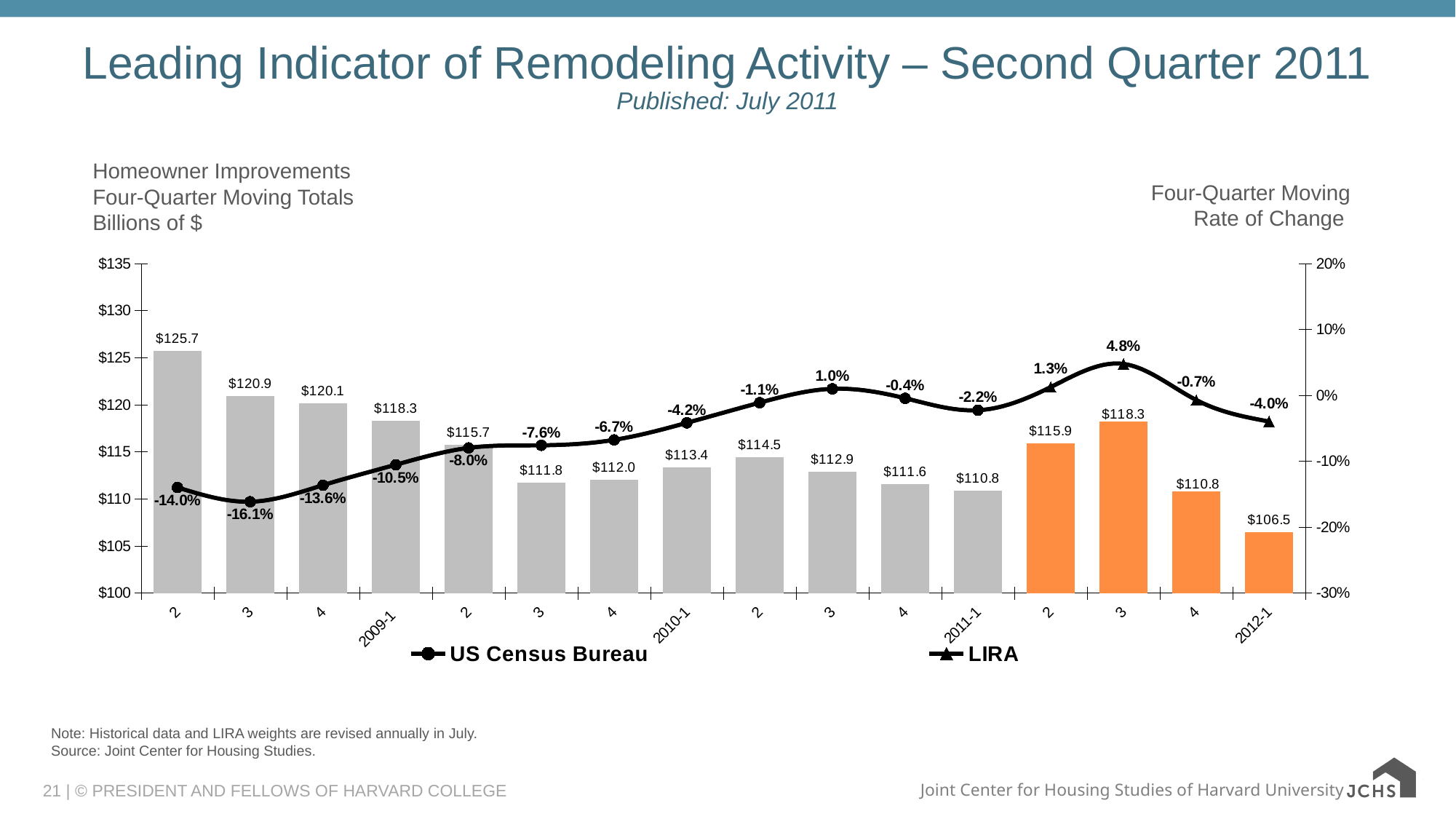
What is the lowest rate-of-change value labeled on the line? -16.1% What is the value of the bar for 2009-1? $118.3 How many bars are plotted on the chart? 16 What is the US Census Bureau rate of change shown for 2010-1? -4.2% How many series does the legend list? 2 Which quarter has the lowest bar value on the chart? 2012-1 What is the LIRA rate of change shown for 2012-1? -4.0% What is the highest bar value shown on the chart? $125.7 Which bar is larger, 2010-1 or 2011-1? 2010-1 What is the value of the bar for 2012-1? $106.5 What is the highest rate-of-change value labeled on the line? 4.8% What is the difference between the bar values for 2011-1 and 2012-1? $4.3